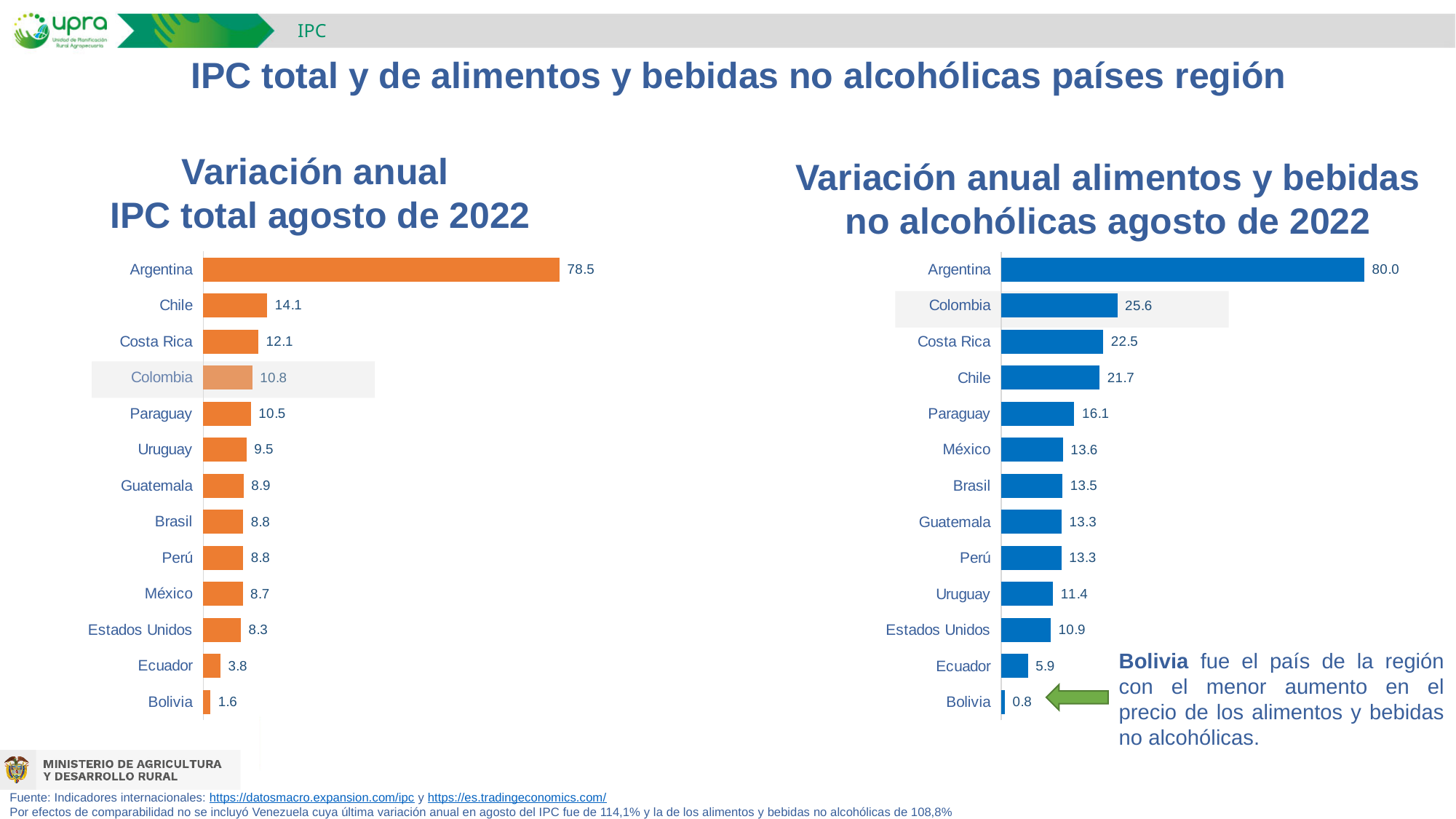
What kind of chart is the 'Variación anual alimentos y bebidas no alcohólicas agosto de 2022' chart? Bar chart In the 'Variación anual alimentos y bebidas no alcohólicas agosto de 2022' chart, what is the value for Colombia? 25.6 In the 'Variación anual IPC total agosto de 2022' chart, which country has the highest value? Argentina In the 'Variación anual IPC total agosto de 2022' chart, what is the value for Colombia? 10.8 In the 'Variación anual alimentos y bebidas no alcohólicas agosto de 2022' chart, which country has the lowest value? Bolivia In the 'Variación anual IPC total agosto de 2022' chart, what is the value for Estados Unidos? 8.3 In the 'Variación anual IPC total agosto de 2022' chart, which is larger, Ecuador or Bolivia? Ecuador How many countries are shown in the 'Variación anual IPC total agosto de 2022' chart? 13 In the 'Variación anual alimentos y bebidas no alcohólicas agosto de 2022' chart, what is the difference between Colombia and Costa Rica? 3.1 In the 'Variación anual IPC total agosto de 2022' chart, what is the difference between Argentina and Chile? 64.4 In the 'Variación anual alimentos y bebidas no alcohólicas agosto de 2022' chart, which is larger, Chile or Paraguay? Chile What colour are the bars in the 'Variación anual IPC total agosto de 2022' chart? Orange